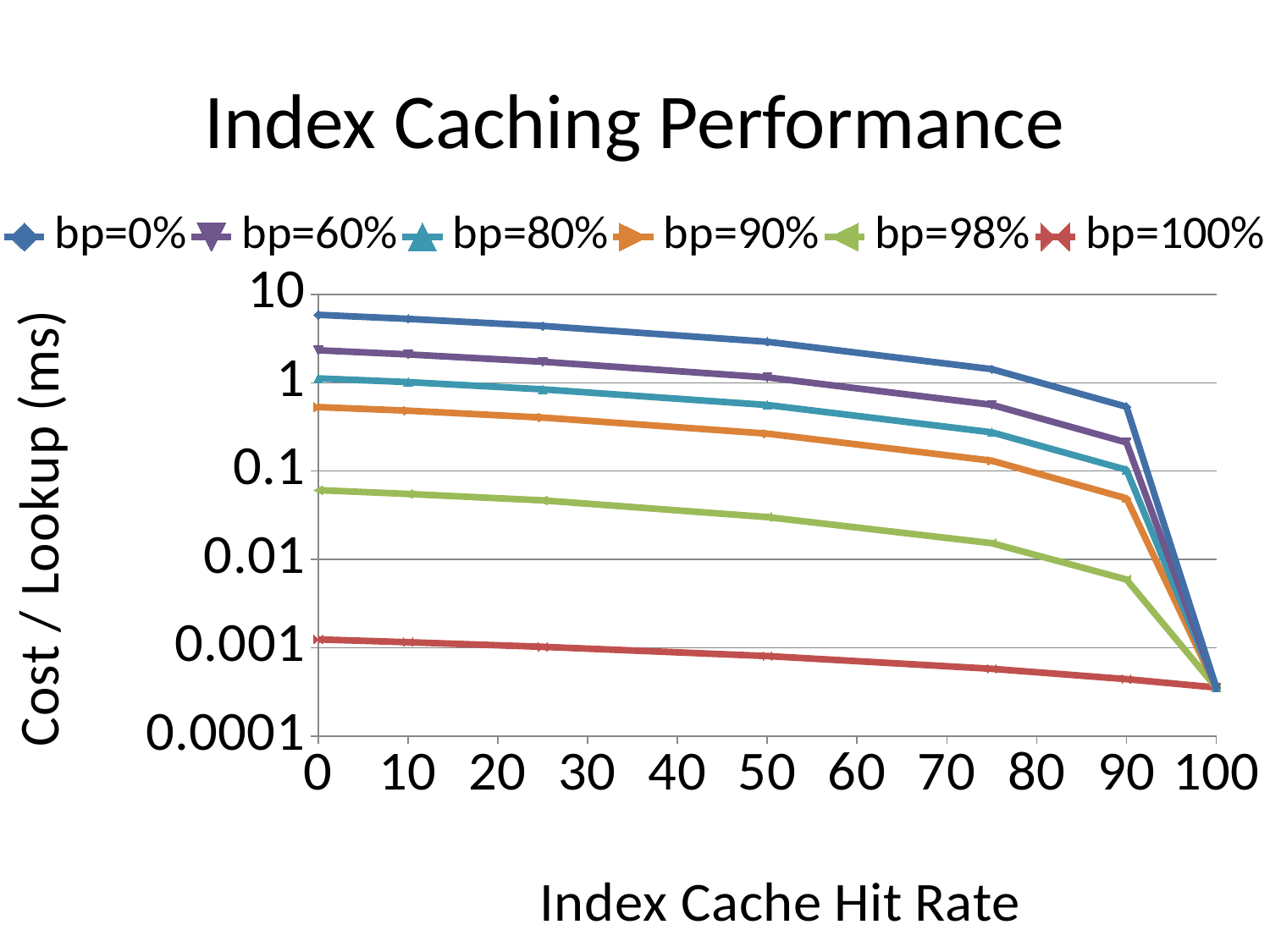
Is the cost per lookup for bp=90% at an index cache hit rate of 0 greater or less than 1? less At an index cache hit rate of 50, which has the higher cost per lookup, bp=0% or bp=100%? bp=0% Does the cost per lookup for bp=0% rise or fall as the index cache hit rate increases? fall Which series has the lowest cost per lookup at an index cache hit rate of 0? bp=100% Is the cost per lookup for bp=0% at an index cache hit rate of 0 greater or less than 1? greater How many series does the legend list? 6 Is the cost per lookup for bp=100% at an index cache hit rate of 0 greater or less than 0.01? less What is the label of the y axis? Cost / Lookup (ms) What is the title of the chart? Index Caching Performance What kind of chart is shown on the slide? line chart Which series has the highest cost per lookup at an index cache hit rate of 0? bp=0%